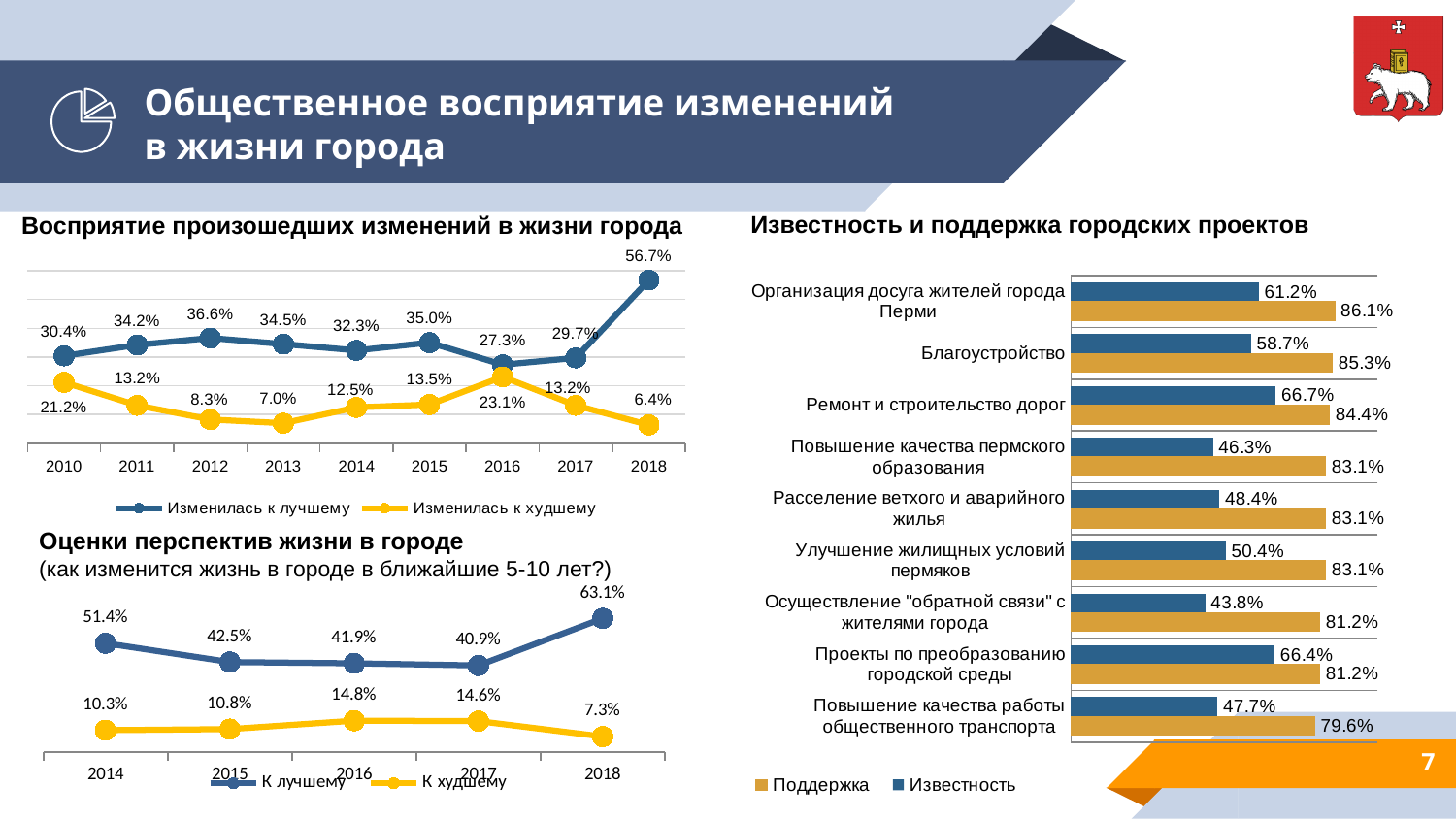
What kind of chart is 'Оценки перспектив жизни в городе'? Line chart In the chart 'Восприятие произошедших изменений в жизни города', what is the value for 'Изменилась к лучшему' in 2018? 56.7% In the chart 'Восприятие произошедших изменений в жизни города', what is the difference between 'Изменилась к лучшему' and 'Изменилась к худшему' in 2018? 50.3 percentage points How many series does the legend of the chart 'Известность и поддержка городских проектов' list? 2 In the chart 'Оценки перспектив жизни в городе', what is the value for 'К худшему' in 2016? 14.8% In the chart 'Восприятие произошедших изменений в жизни города', in which year is 'Изменилась к худшему' highest? 2016 In the chart 'Оценки перспектив жизни в городе', in which year is 'К лучшему' highest? 2018 In the chart 'Восприятие произошедших изменений в жизни города', in which year is 'Изменилась к худшему' lowest? 2018 In the chart 'Известность и поддержка городских проектов', which project has the lowest 'Известность' value? Осуществление "обратной связи" с жителями города In the chart 'Известность и поддержка городских проектов', what is the 'Известность' value for 'Ремонт и строительство дорог'? 66.7% How many years are shown on the x axis of the chart 'Восприятие произошедших изменений в жизни города'? 9 In the chart 'Известность и поддержка городских проектов', which project has the highest 'Поддержка' value? Организация досуга жителей города Перми